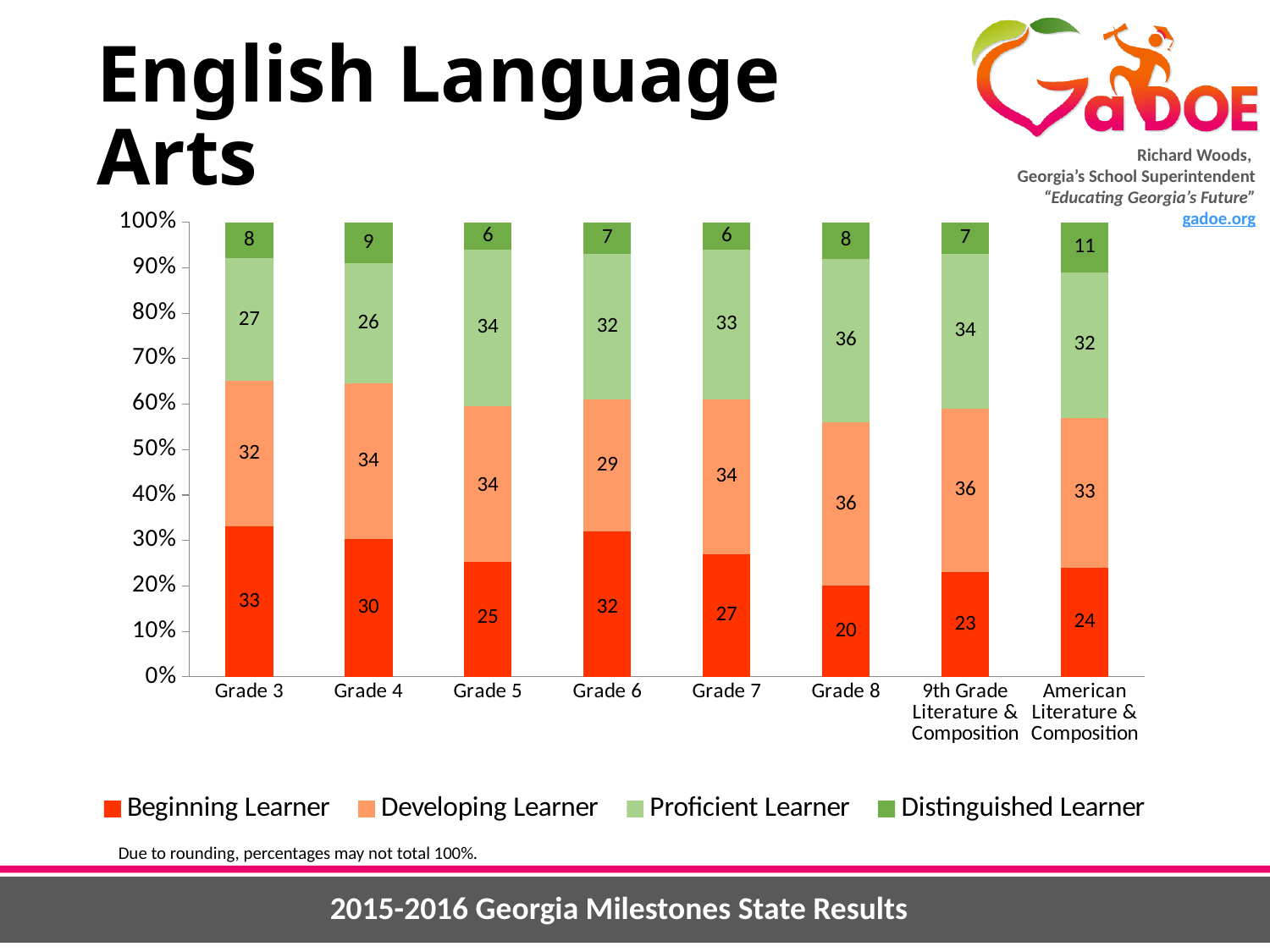
What is the Proficient Learner value for Grade 8? 36 Which category has the highest Beginning Learner value? Grade 3 What is the difference between the Beginning Learner values for Grade 3 and Grade 8? 13 Which category has the lowest Beginning Learner value? Grade 8 Which category has the highest Distinguished Learner value? American Literature & Composition What is the Distinguished Learner value for American Literature & Composition? 11 How many categories are shown on the x axis? 8 What kind of chart is shown on the slide? Stacked bar chart What percentage of Grade 3 students are Beginning Learners? 33 Which is larger, the Proficient Learner value for Grade 5 or for Grade 4? Grade 5 How many series does the legend list? 4 What is the Developing Learner value for 9th Grade Literature & Composition? 36